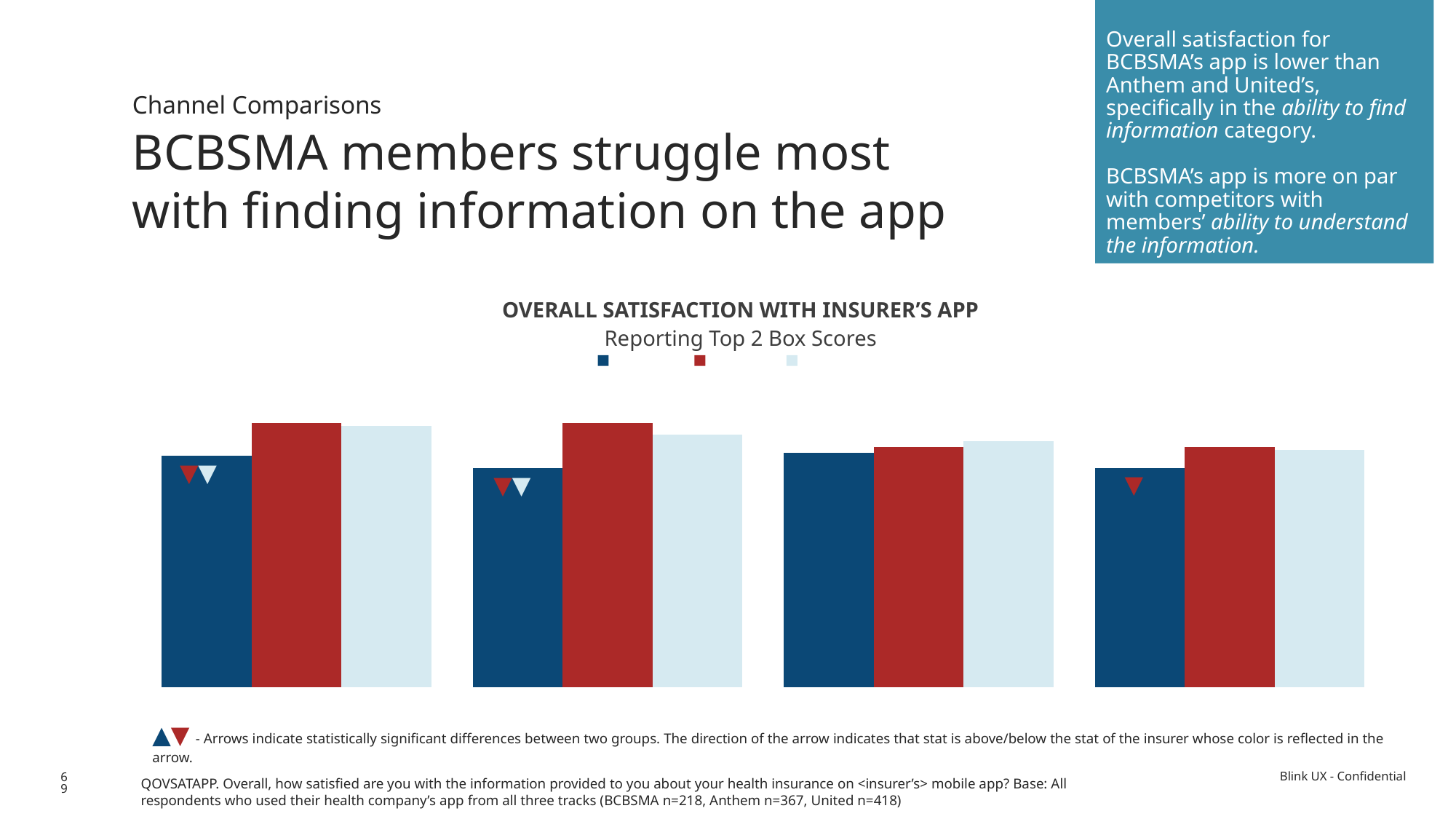
What is the title of the chart? OVERALL SATISFACTION WITH INSURER'S APP What kind of chart is shown on the slide? Bar chart How many series does the chart's legend show? 3 How many groups of bars are plotted in the chart? 4 In the rightmost group of bars, is the dark blue bar or the red bar taller? Red In the second group of bars from the left, is the dark blue bar or the red bar taller? Red How many bars are plotted in the chart in total? 12 What does the chart's subtitle say it is reporting? Top 2 Box Scores In the second group of bars from the left, which colored bar is the shortest? Dark blue In the third group of bars from the left, which colored bar is the tallest? Light blue In the leftmost group of bars, which colored bar is the tallest? Red In the leftmost group of bars, which colored bar is the shortest? Dark blue